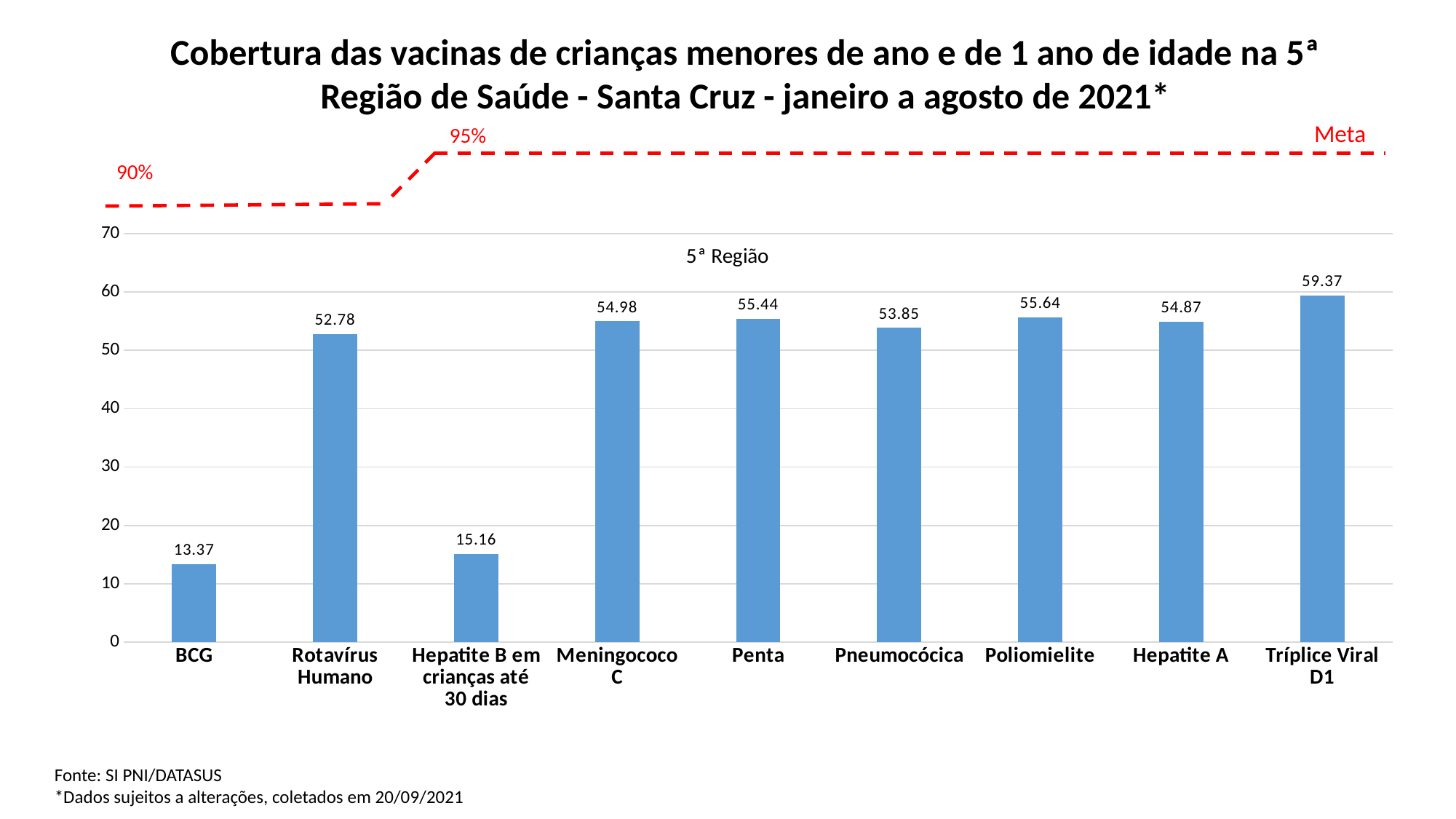
What is the coverage value for Tríplice Viral D1? 59.37 Which vaccine has the lowest coverage value? BCG Is the value for Meningococo C greater or less than 50? greater What is the coverage value for Hepatite B em crianças até 30 dias? 15.16 What kind of chart is shown on the slide? bar chart What is the coverage value for BCG? 13.37 Which vaccine has the highest coverage value? Tríplice Viral D1 What is the difference between the coverage values for Rotavírus Humano and Hepatite B em crianças até 30 dias? 37.62 What is the coverage value for Pneumocócica? 53.85 How many vaccines are shown on the x axis? 9 Which has a higher coverage value, Rotavírus Humano or Hepatite A? Hepatite A What is the difference between the coverage values for Tríplice Viral D1 and BCG? 46.00